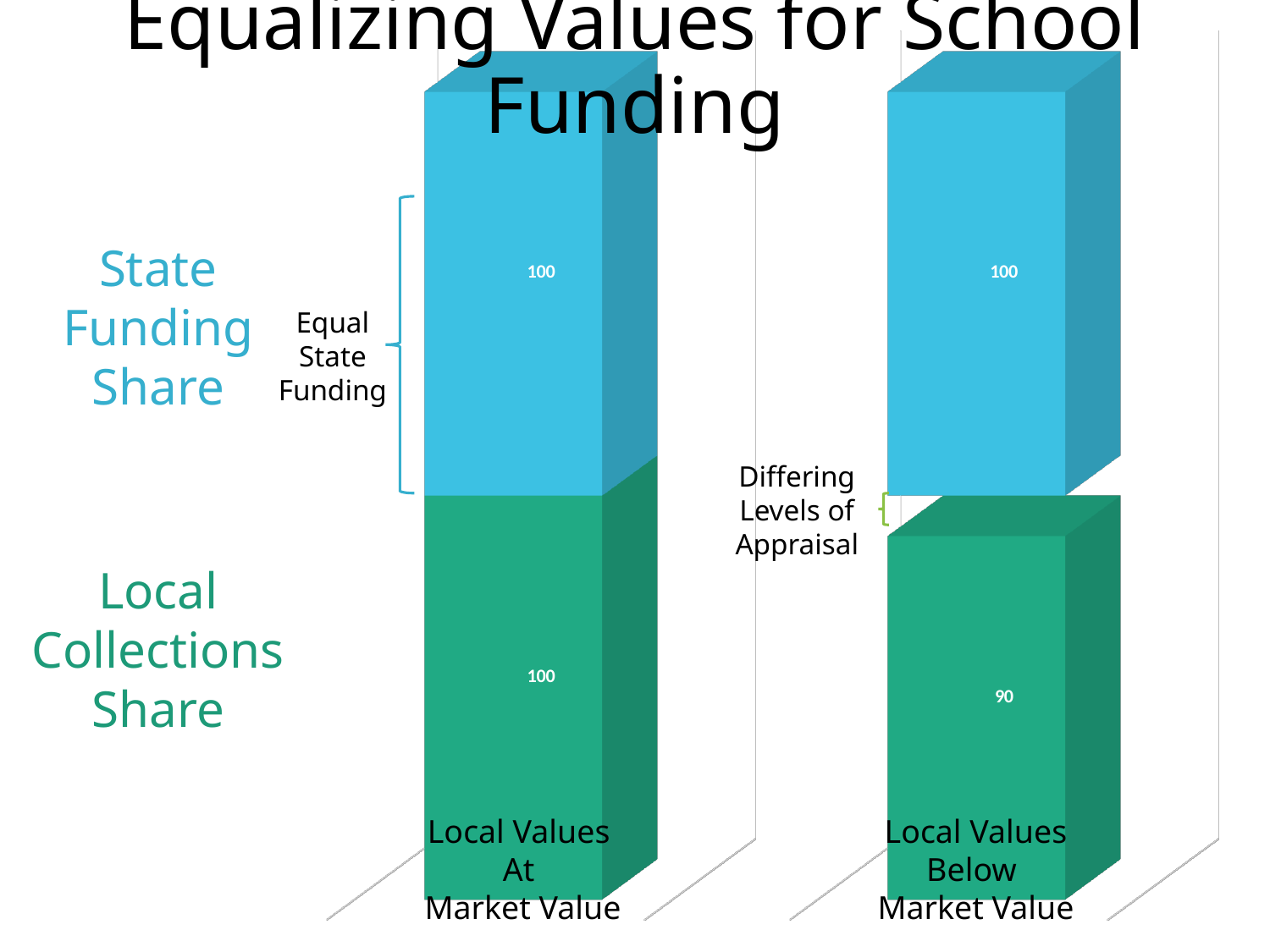
What is the State Funding Share value for Local Values Below Market Value? 100 What is the total of the stacked bar for Local Values Below Market Value? 190 Which category has the lower Local Collections Share value? Local Values Below Market Value What is the State Funding Share value for Local Values At Market Value? 100 What is the total of the stacked bar for Local Values At Market Value? 200 What is the difference in Local Collections Share between Local Values At Market Value and Local Values Below Market Value? 10 What kind of chart is shown on the slide? Stacked bar chart What is the Local Collections Share value for Local Values Below Market Value? 90 What is the Local Collections Share value for Local Values At Market Value? 100 Which colour represents the State Funding Share? Blue Is the Local Collections Share larger for Local Values At Market Value or for Local Values Below Market Value? Local Values At Market Value How many categories are shown on the chart? 2